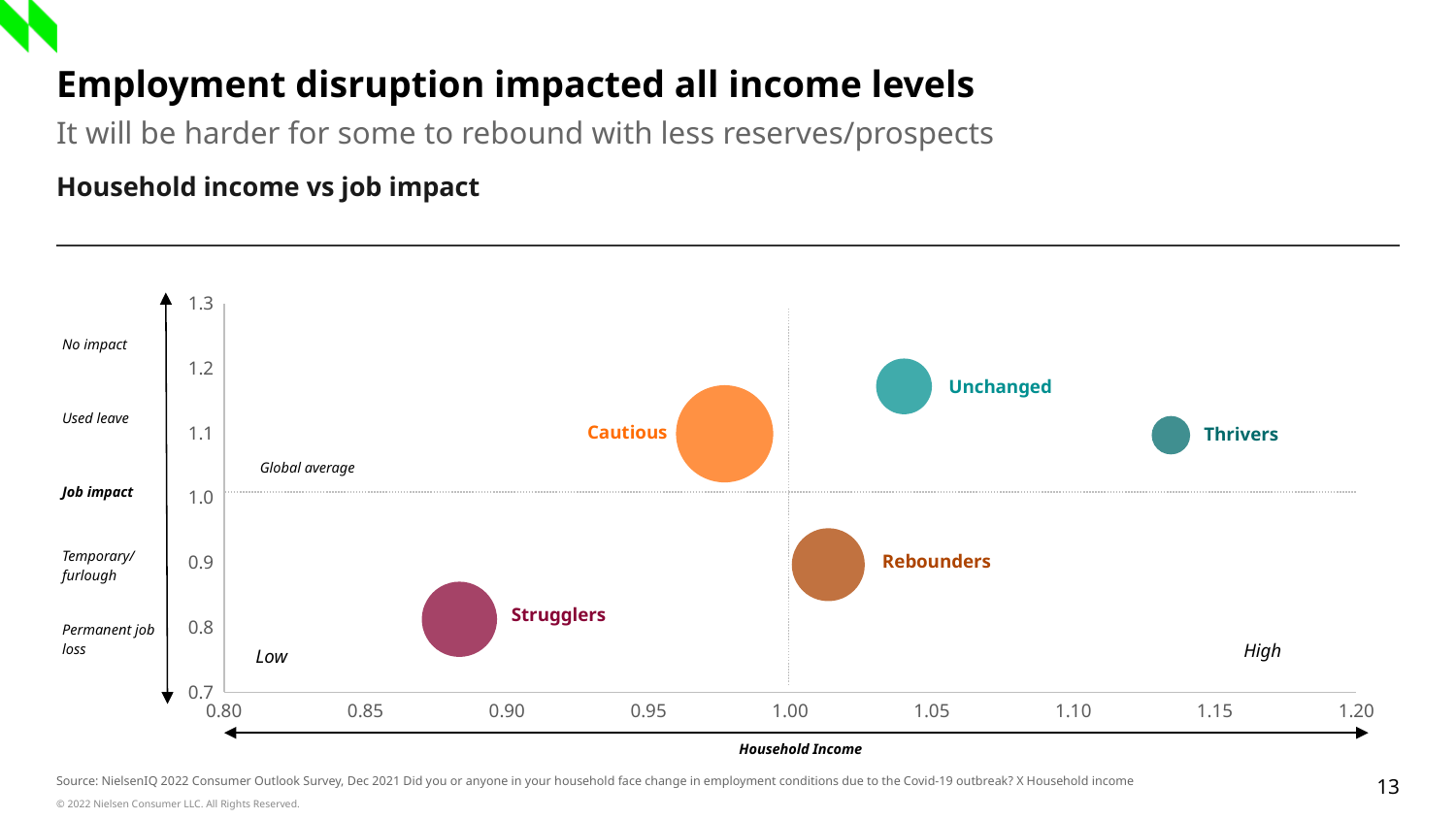
Is the job impact value for Unchanged greater or less than 1.1? greater Is the household income value for Cautious greater or less than 1.00? less How many segments (bubbles) are plotted on the chart? 5 Is the household income value for Thrivers greater or less than 1.10? greater Which segment has the lowest household income on the chart? Strugglers What kind of chart is shown on the slide? Bubble chart What is the label of the horizontal axis of the chart? Household Income Which segment has the highest household income on the chart? Thrivers Which segment has the higher job impact value, Unchanged or Rebounders? Unchanged Which segment is plotted lowest on the job impact axis? Strugglers Which segment is plotted highest on the job impact axis? Unchanged